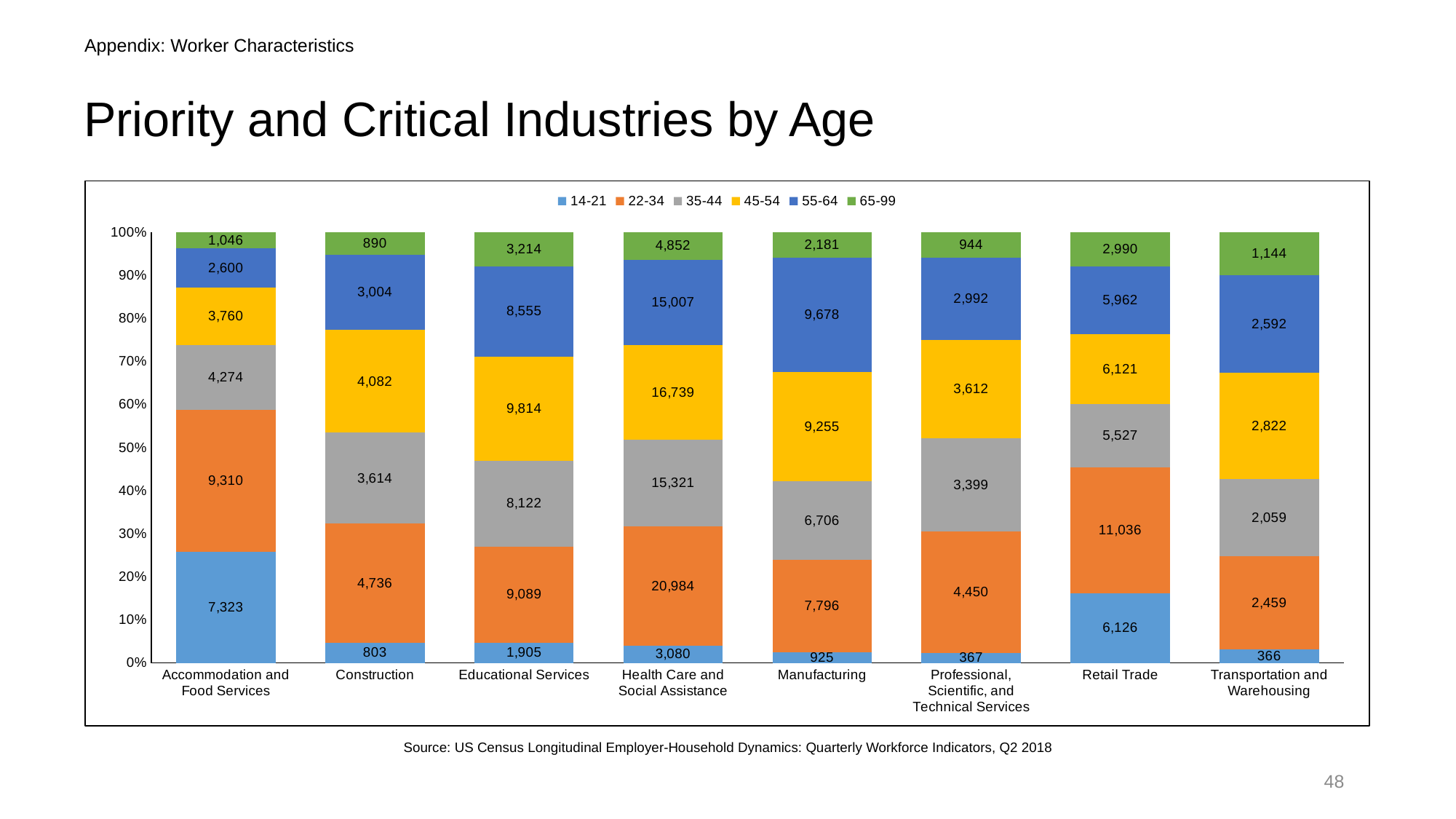
What kind of chart is shown on the slide? Stacked bar chart What is the total of all age groups in the Construction bar? 17,129 Which industry has the smallest value for the 65-99 age group? Construction What is the value for the 14-21 age group in Retail Trade? 6,126 What is the difference between the 22-34 and 14-21 values in Retail Trade? 4,910 Which is larger: the 55-64 value for Educational Services or for Manufacturing? Manufacturing What is the difference between the 45-54 and 35-44 values in Health Care and Social Assistance? 1,418 What is the value for the 55-64 age group in Manufacturing? 9,678 How many age groups does the legend list? 6 Which industry has the largest value for the 22-34 age group? Health Care and Social Assistance How many industries are shown on the x axis? 8 What is the value for the 22-34 age group in Health Care and Social Assistance? 20,984